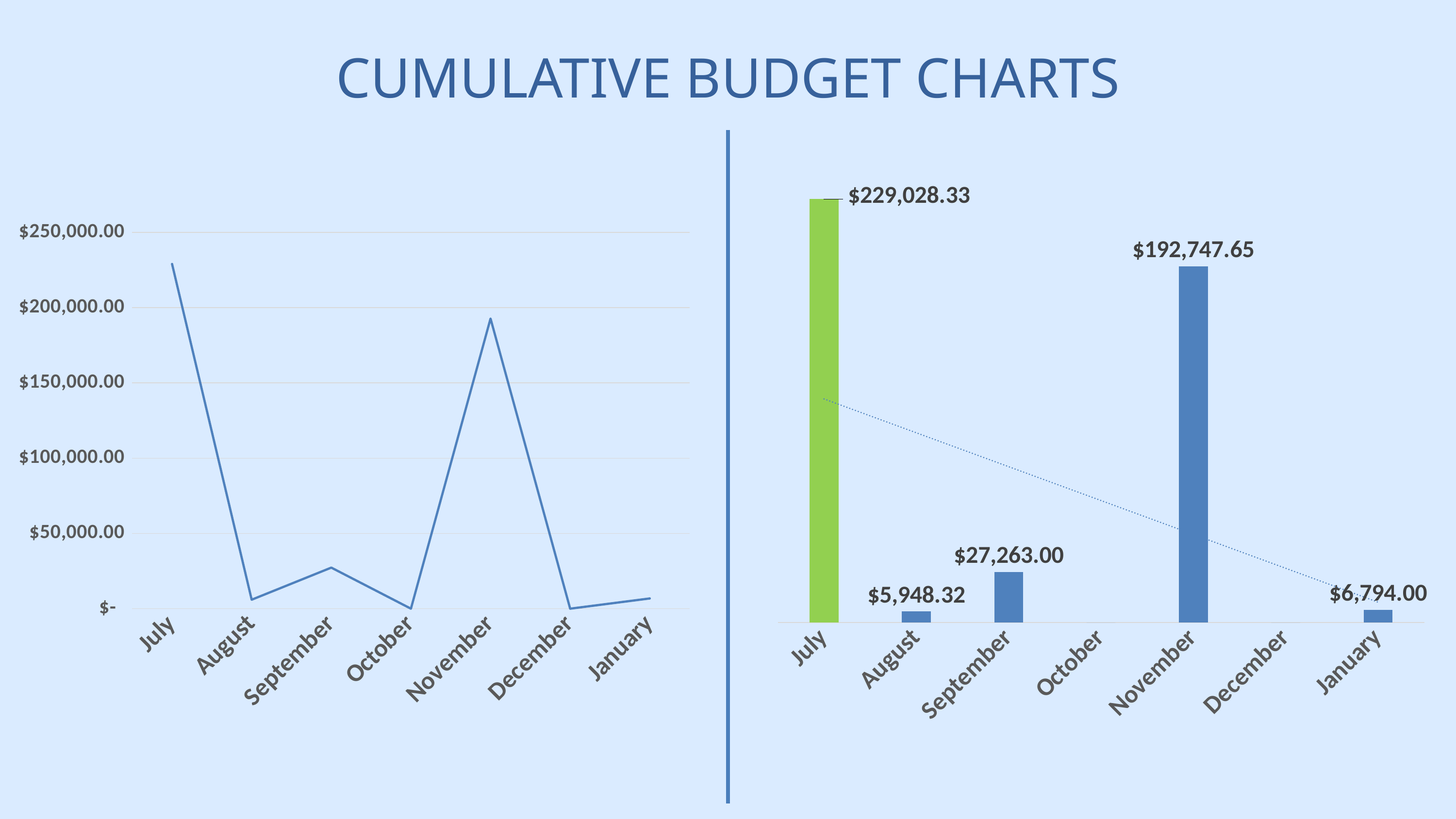
On the left-hand line chart, is the value for November greater or less than $150,000.00? greater On the right-hand bar chart, what is the value for July? $229,028.33 On the right-hand bar chart, what is the value for January? $6,794.00 What kind of chart is the left-hand chart? line chart On the right-hand bar chart, what is the difference between the July and November values? $36,280.68 On the right-hand bar chart, which is larger, the value for August or the value for September? September On the right-hand bar chart, what is the value for September? $27,263.00 On the left-hand line chart, is the value for September greater or less than $50,000.00? less How many months are shown on the x axis of the left-hand chart? 7 On the right-hand bar chart, what is the value for November? $192,747.65 On the right-hand bar chart, which month has the tallest bar? July On the right-hand bar chart, what is the difference between the September and January values? $20,469.00